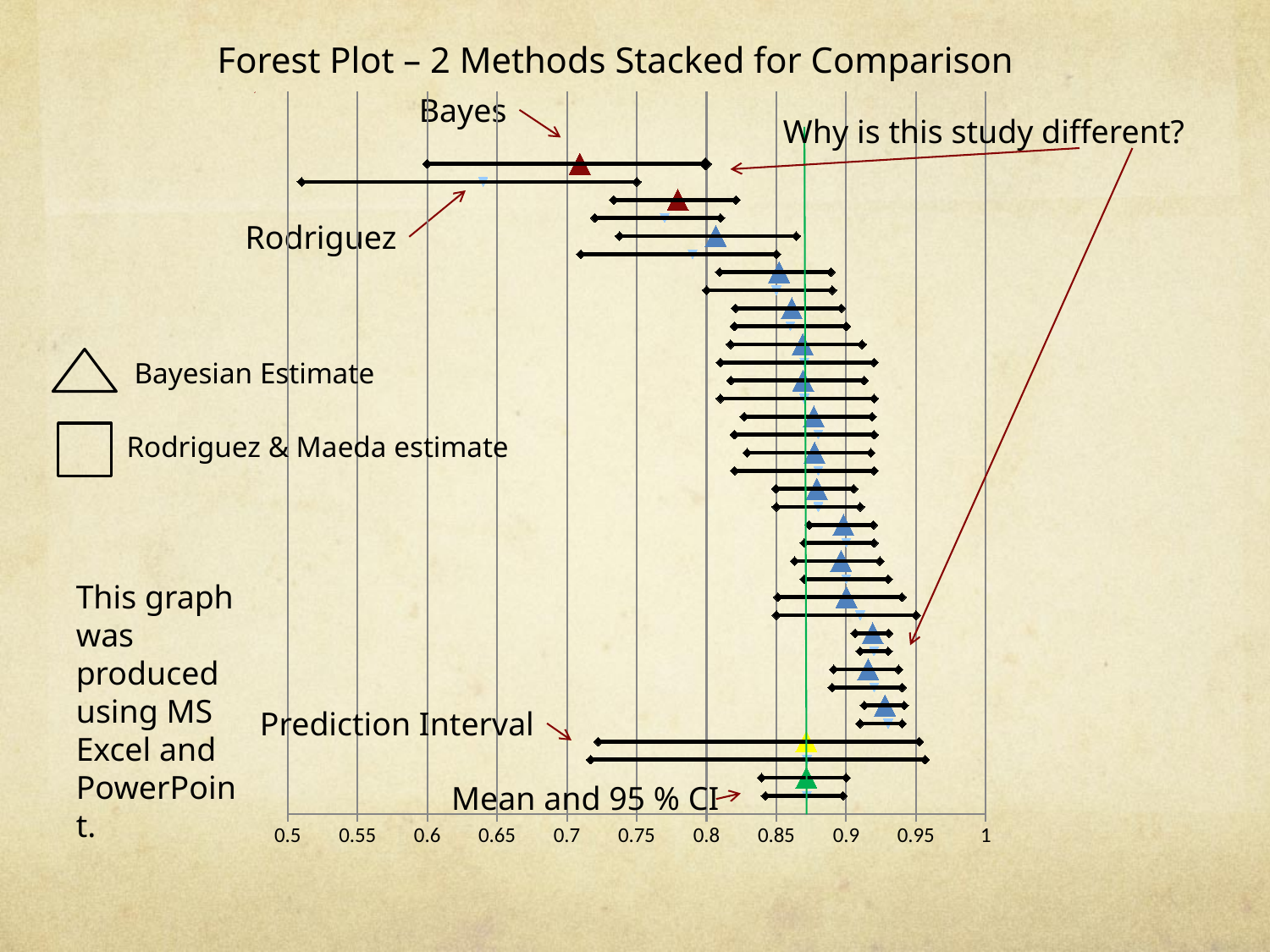
Is the Bayesian estimate for the topmost study larger or smaller than the overall mean? smaller Is the lower end of the Rodriguez confidence interval for the topmost study greater or less than 0.55? less Is the Bayesian estimate for the topmost study greater or less than 0.75? less Do the study estimates generally increase or decrease going from the top of the plot to the bottom? increase Which study has the lowest Bayesian estimate, the topmost study or the bottommost study? The topmost study What kind of chart is shown on the slide? Forest plot Which symbol does the legend use for the Bayesian Estimate? Triangle Is the overall mean (green vertical line) greater or less than 0.85? greater How many estimation methods does the legend list? 2 What is the title of the chart? Forest Plot – 2 Methods Stacked for Comparison